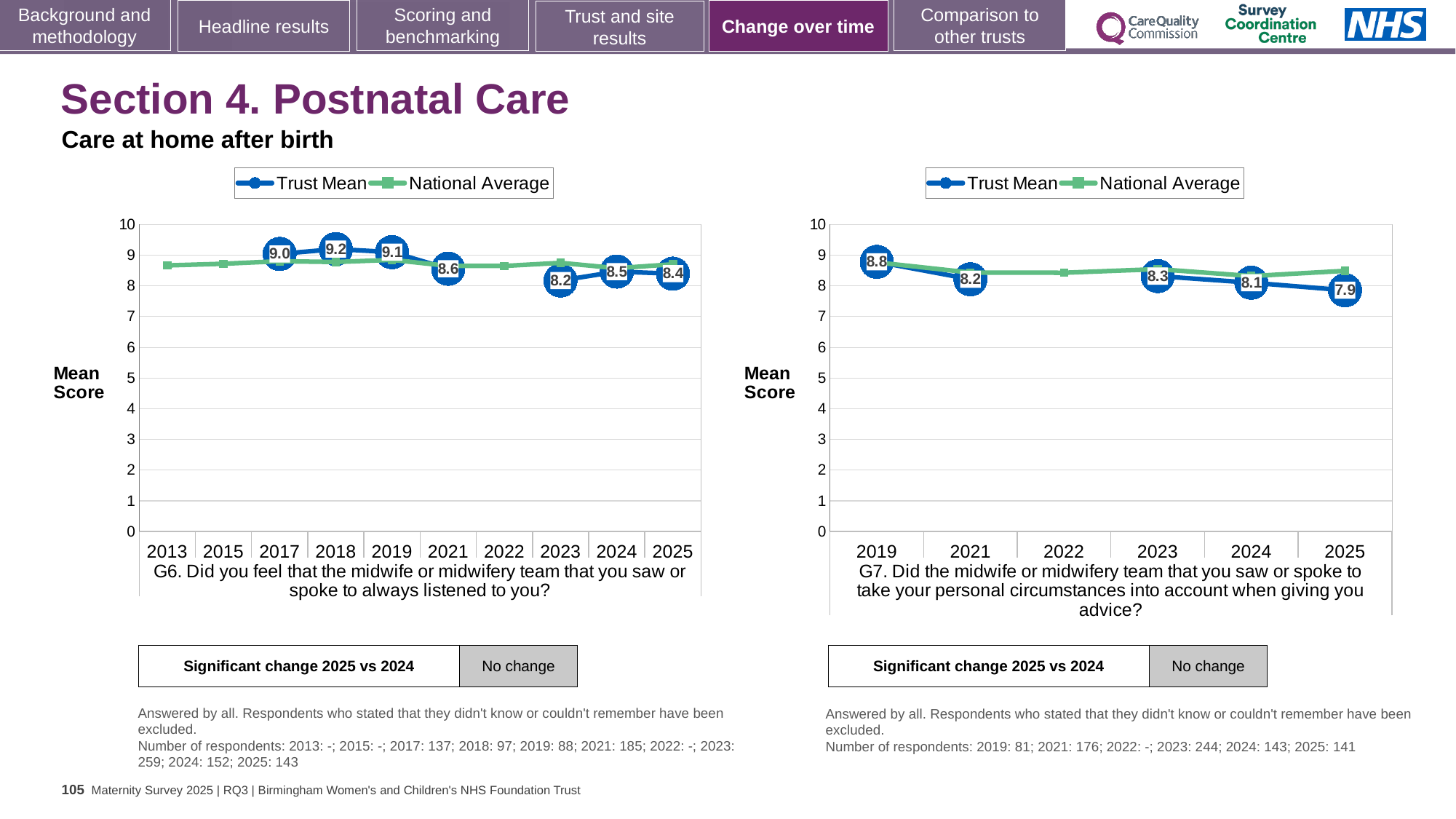
In the G6 chart (left), which year has the highest Trust Mean? 2018 In the G7 chart (right), which year has the highest Trust Mean? 2019 In the G7 chart (right), what is the difference between the Trust Mean in 2019 and in 2025? 0.9 In the G6 chart (left), how many years are shown on the x axis? 10 In the G6 chart (left), what is the Trust Mean for 2018? 9.2 In the G6 chart (left), what is the difference between the Trust Mean in 2018 and in 2025? 0.8 In the G7 chart (right), how many series does the legend list? 2 What type of chart is the G7 chart (right)? Line chart In the G6 chart (left), what is the Trust Mean for 2023? 8.2 In the G7 chart (right), is the Trust Mean higher in 2021 or in 2023? 2023 In the G6 chart (left), which year has the lowest labelled Trust Mean? 2023 In the G7 chart (right), what is the Trust Mean for 2025? 7.9